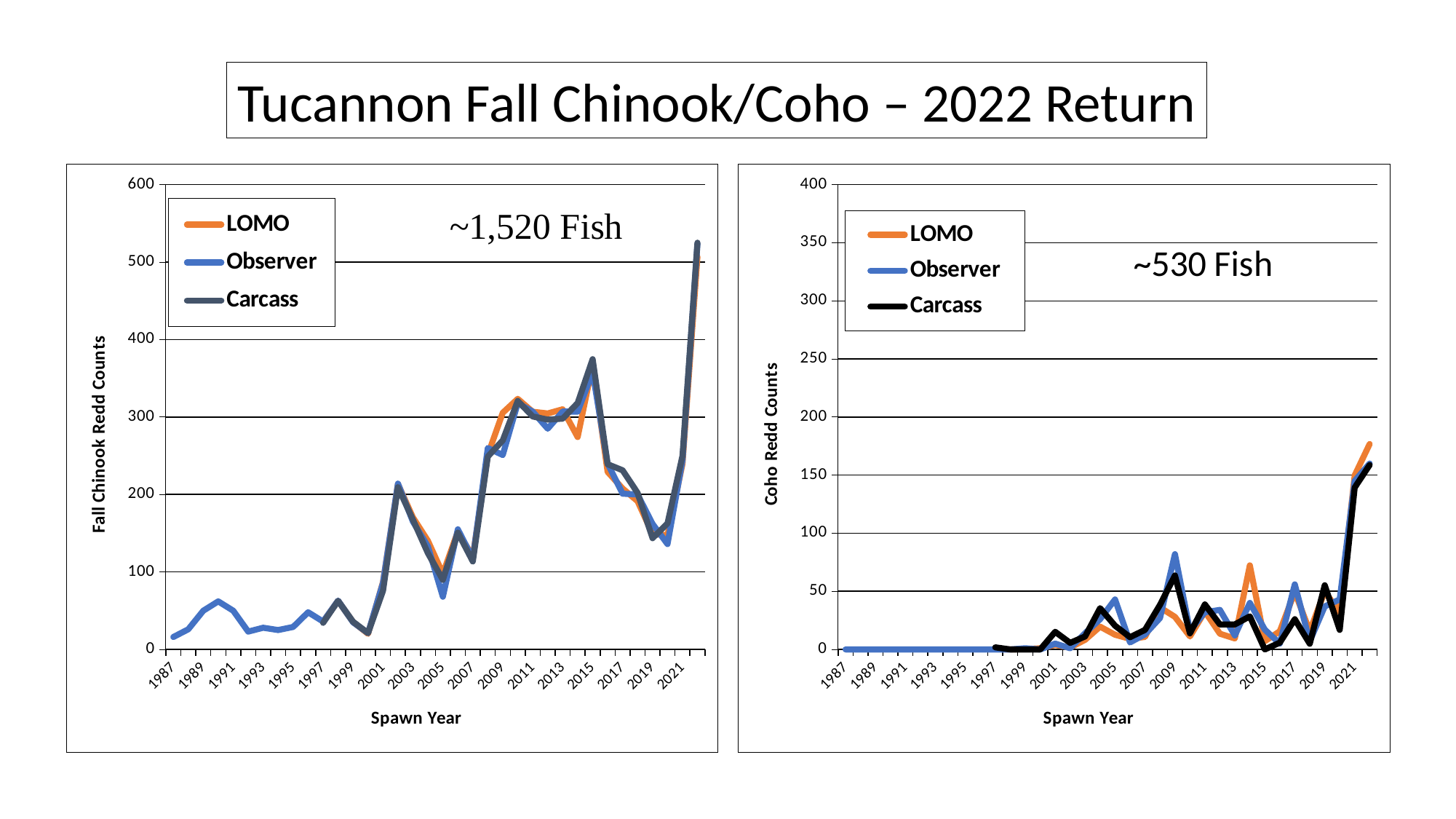
In the left chart (Fall Chinook Redd Counts), is the value for the final spawn year (2022) greater or less than 400? greater In the left chart (Fall Chinook Redd Counts), do the redd counts overall rise or fall from 1987 to 2022? rise In the left chart (Fall Chinook Redd Counts), is the Carcass value for 2015 greater or less than 300? greater In the left chart (Fall Chinook Redd Counts), in which spawn year do the lines reach their highest value? 2022 What are the three series named in the legend of the left chart (Fall Chinook Redd Counts)? LOMO, Observer, Carcass What is the x-axis label on the right chart (Coho Redd Counts)? Spawn Year What kind of chart is the left chart (Fall Chinook Redd Counts)? line chart How many series does the legend of the right chart (Coho Redd Counts) list? 3 In the right chart (Coho Redd Counts), is the Observer value for 2009 greater or less than 50? greater